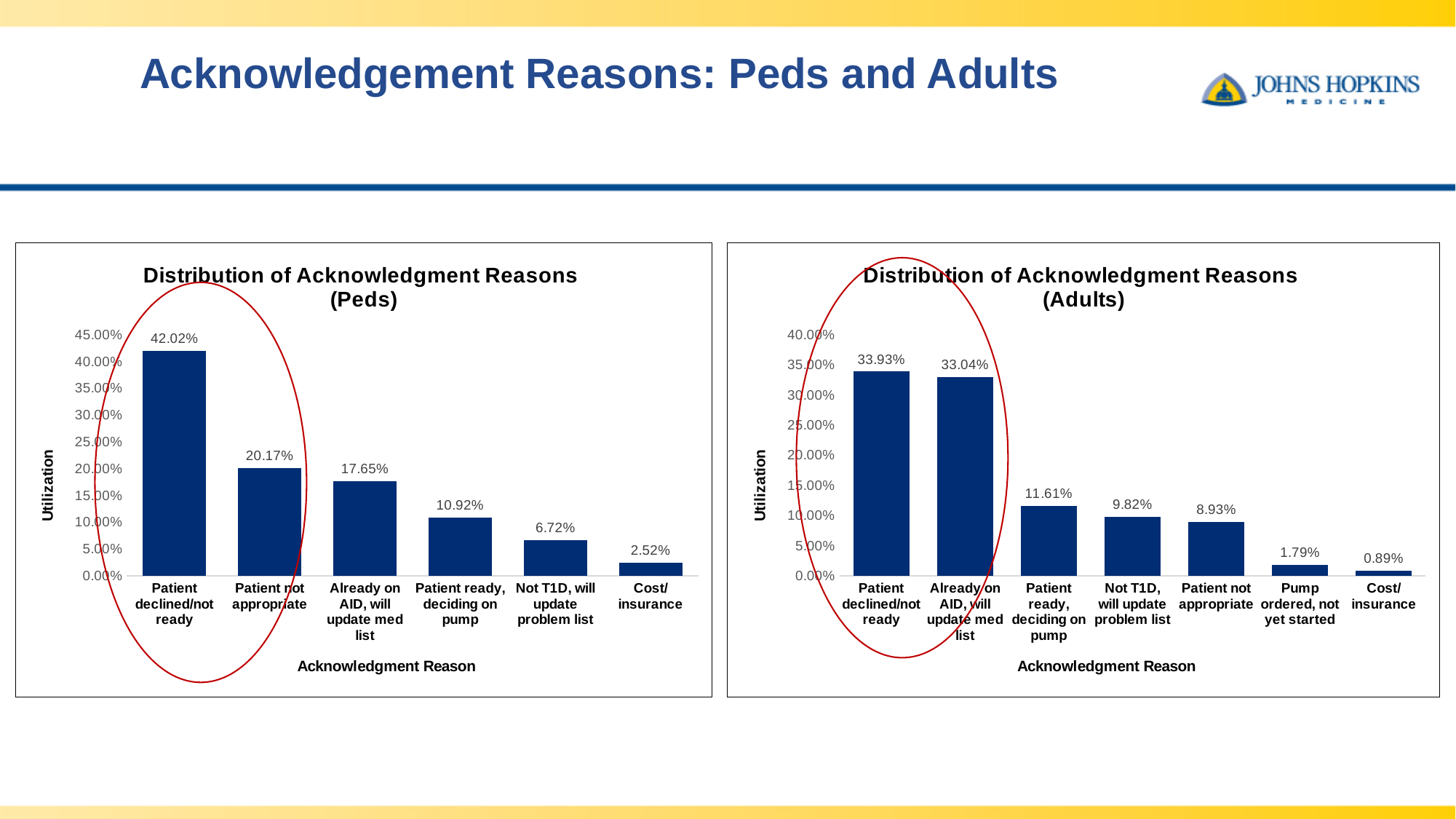
In the Adults chart, what is the value for Pump ordered, not yet started? 1.79% In the Peds chart, what is the difference between Patient declined/not ready and Patient not appropriate? 21.85% In the Peds chart, what is the value for Patient declined/not ready? 42.02% What is the label on the y axis of the Peds chart? Utilization In the Adults chart, which acknowledgment reason has the highest utilization? Patient declined/not ready In the Adults chart, what is the value for Already on AID, will update med list? 33.04% In the Adults chart, which is larger: Patient ready, deciding on pump or Patient not appropriate? Patient ready, deciding on pump In the Peds chart, how many acknowledgment reasons are shown? 6 In the Peds chart, do the values rise or fall from left to right along the x axis? Fall What type of chart is the Distribution of Acknowledgment Reasons (Adults) chart? Bar chart In the Peds chart, which acknowledgment reason has the lowest utilization? Cost/insurance In the Adults chart, how many acknowledgment reasons are shown? 7